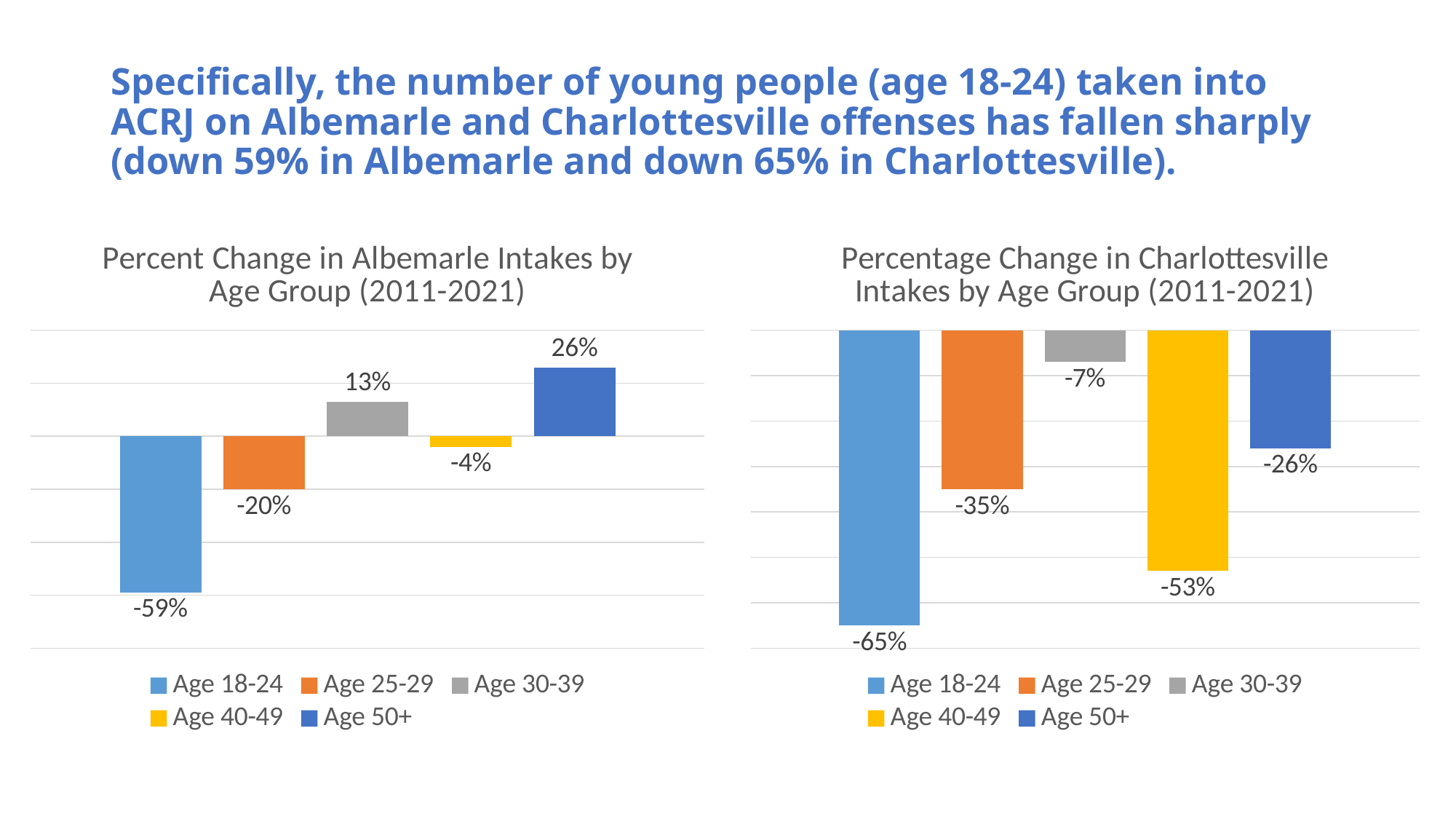
What type of chart is the 'Percentage Change in Charlottesville Intakes by Age Group (2011-2021)' chart? Bar chart In the Albemarle chart on the left, which age group has the lowest value? Age 18-24 In the Charlottesville chart on the right, what is the difference between the values for Age 25-29 and Age 50+? 9 percentage points How many age groups are shown in the Charlottesville chart on the right? 5 In the Albemarle chart on the left, which age group has the highest value? Age 50+ In the 'Percent Change in Albemarle Intakes by Age Group (2011-2021)' chart, what is the value for Age 18-24? -59% In the Albemarle chart on the left, what is the value for Age 50+? 26% How many entries does the legend of the Albemarle chart on the left list? 5 In the Charlottesville chart on the right, what is the value for Age 30-39? -7% In the Albemarle chart on the left, which is larger: the value for Age 30-39 or the value for Age 40-49? Age 30-39 In the Charlottesville chart on the right, which age group has the lowest value? Age 18-24 In the 'Percentage Change in Charlottesville Intakes by Age Group (2011-2021)' chart, what is the value for Age 40-49? -53%